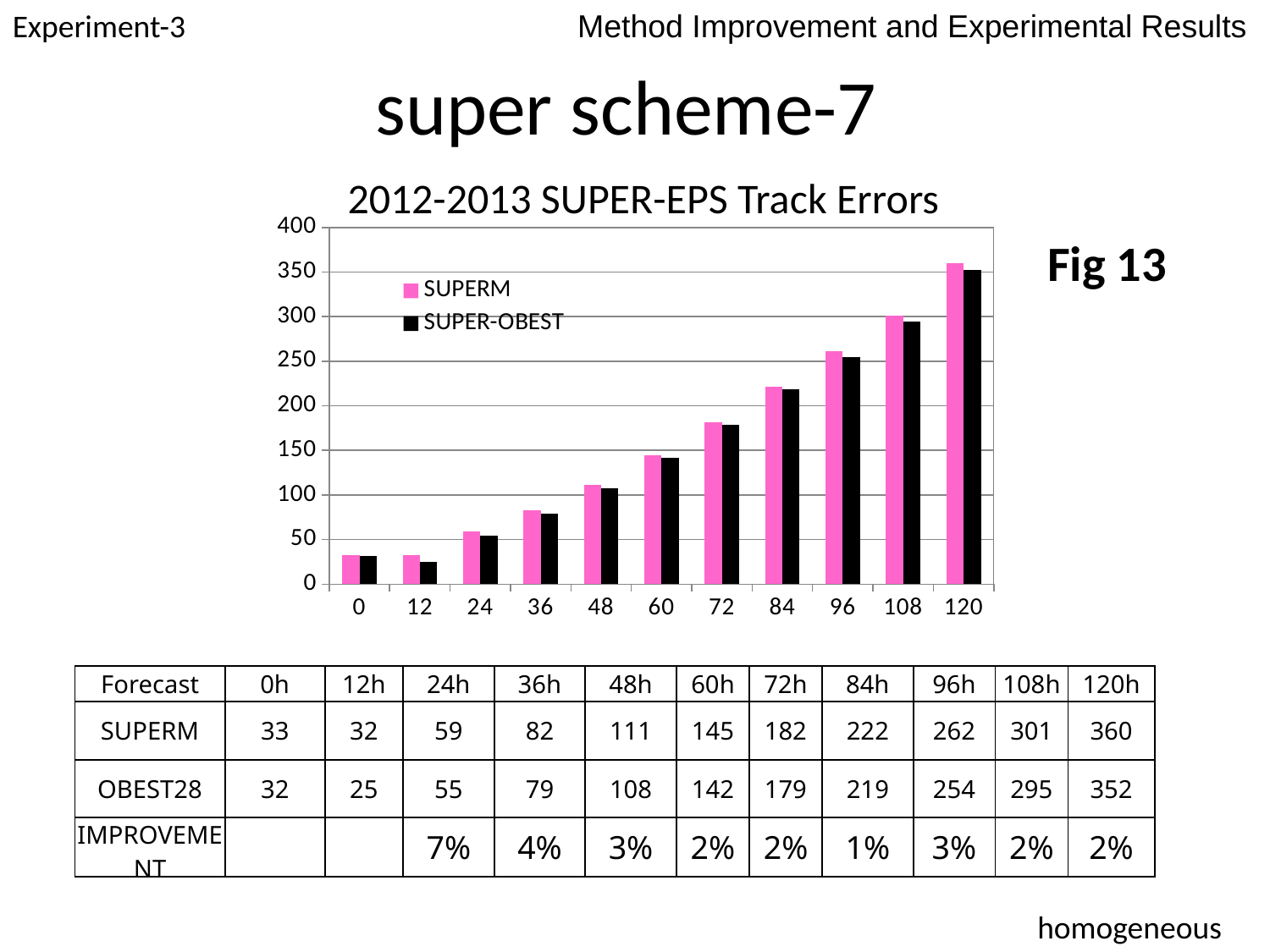
Do the track errors rise or fall as the forecast hour increases along the x axis? rise At which forecast hour is the SUPER-OBEST track error lowest? 12 Which series is shown in pink in the chart? SUPERM What type of chart is shown on the slide? bar chart At 96 hours, which series has the larger track error, SUPERM or SUPER-OBEST? SUPERM How many series does the chart legend list? 2 What is the title of the chart? 2012-2013 SUPER-EPS Track Errors According to the table below the chart, what is the SUPERM track error at 48h? 111 Is the SUPERM value at 120 hours greater or less than 350? greater How many forecast-hour categories are shown on the x axis of the chart? 11 Is the SUPER-OBEST value at 72 hours greater or less than 200? less At which forecast hour is the SUPERM track error highest? 120